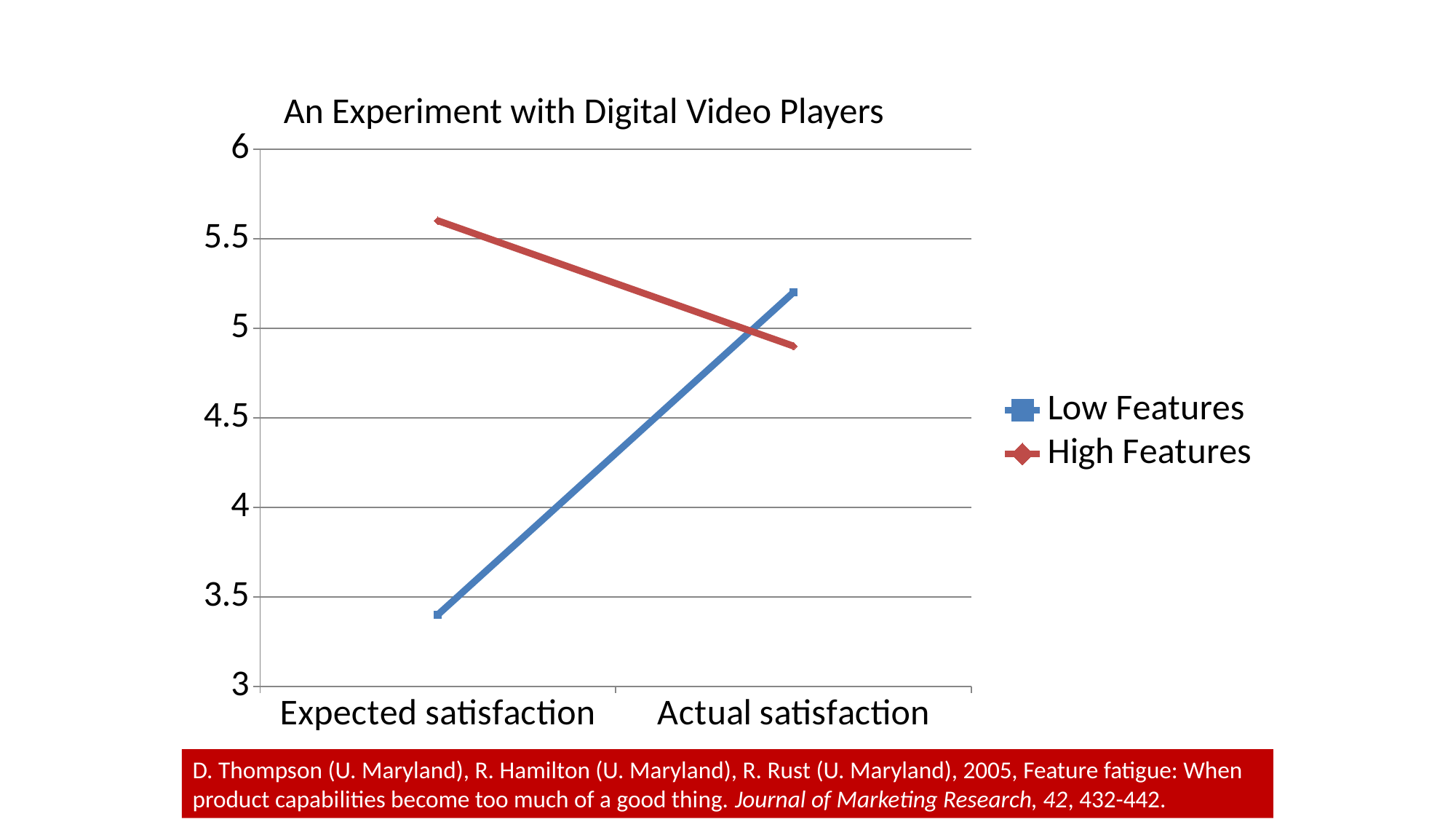
Is the Low Features value for Expected satisfaction greater or less than 4? less Which series is drawn in blue? Low Features Is the High Features value for Actual satisfaction greater or less than 5.5? less Does the High Features line rise or fall from Expected satisfaction to Actual satisfaction? fall How many series does the legend list? 2 For Expected satisfaction, which series has the higher value, Low Features or High Features? High Features Is the High Features value for Expected satisfaction greater or less than 5? greater What is the title of the chart? An Experiment with Digital Video Players Does the Low Features line rise or fall from Expected satisfaction to Actual satisfaction? rise How many categories are shown on the x axis? 2 What kind of chart is shown on the slide? line chart